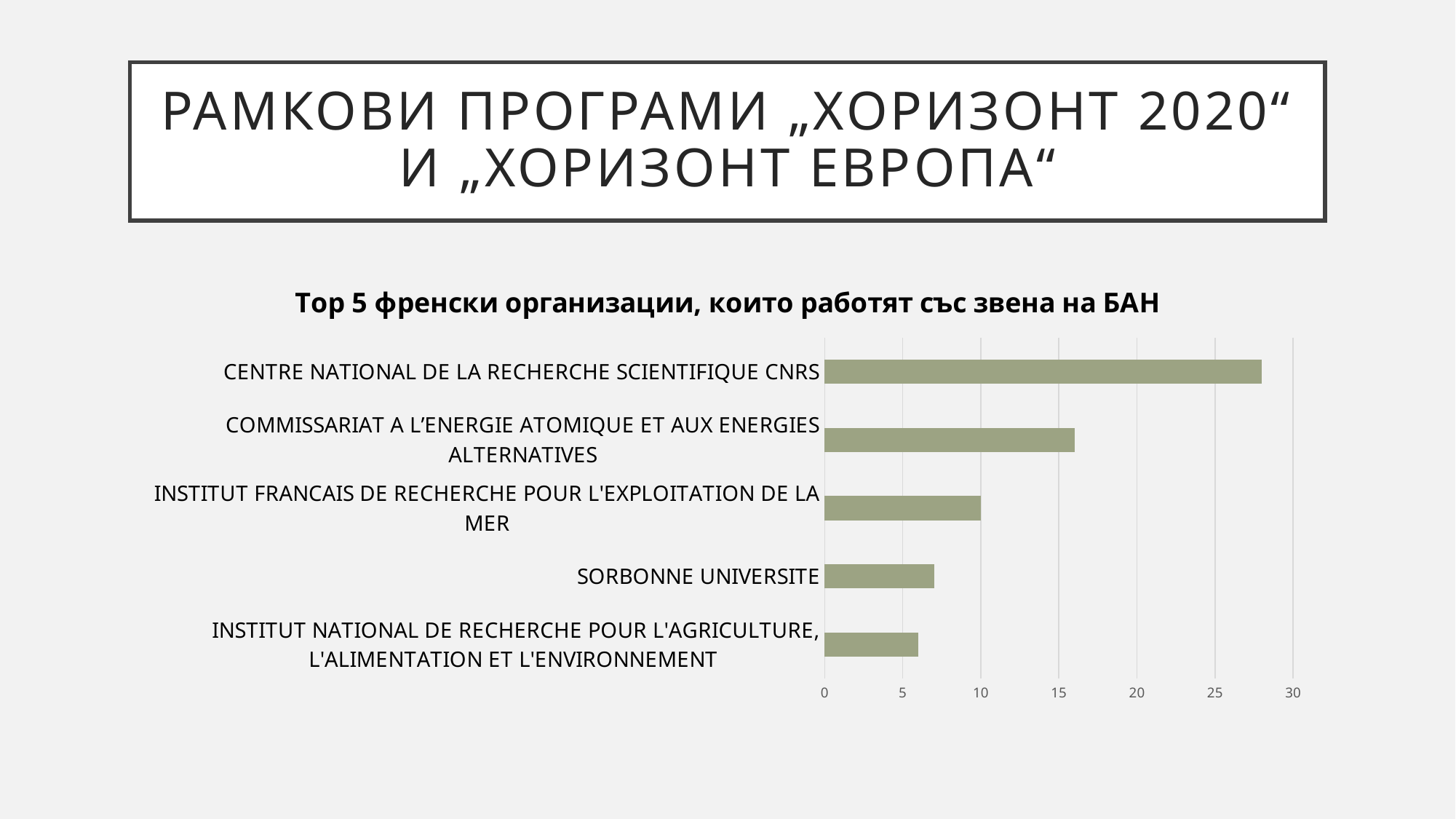
Is the value for COMMISSARIAT A L'ENERGIE ATOMIQUE ET AUX ENERGIES ALTERNATIVES greater or less than 20? less Is the value for SORBONNE UNIVERSITE greater or less than 5? greater Which organization has the highest value in the chart? CENTRE NATIONAL DE LA RECHERCHE SCIENTIFIQUE CNRS Is the value for CENTRE NATIONAL DE LA RECHERCHE SCIENTIFIQUE CNRS greater or less than 25? greater What is the title of the chart? Top 5 френски организации, които работят със звена на БАН Which has a larger value, CENTRE NATIONAL DE LA RECHERCHE SCIENTIFIQUE CNRS or COMMISSARIAT A L'ENERGIE ATOMIQUE ET AUX ENERGIES ALTERNATIVES? CENTRE NATIONAL DE LA RECHERCHE SCIENTIFIQUE CNRS Which has a larger value, SORBONNE UNIVERSITE or INSTITUT FRANCAIS DE RECHERCHE POUR L'EXPLOITATION DE LA MER? INSTITUT FRANCAIS DE RECHERCHE POUR L'EXPLOITATION DE LA MER What kind of chart is shown on the slide? bar chart What is the value for INSTITUT FRANCAIS DE RECHERCHE POUR L'EXPLOITATION DE LA MER? 10 What is the maximum value shown on the horizontal axis of the chart? 30 How many organizations are shown in the chart? 5 Which organization has the lowest value in the chart? INSTITUT NATIONAL DE RECHERCHE POUR L'AGRICULTURE, L'ALIMENTATION ET L'ENVIRONNEMENT